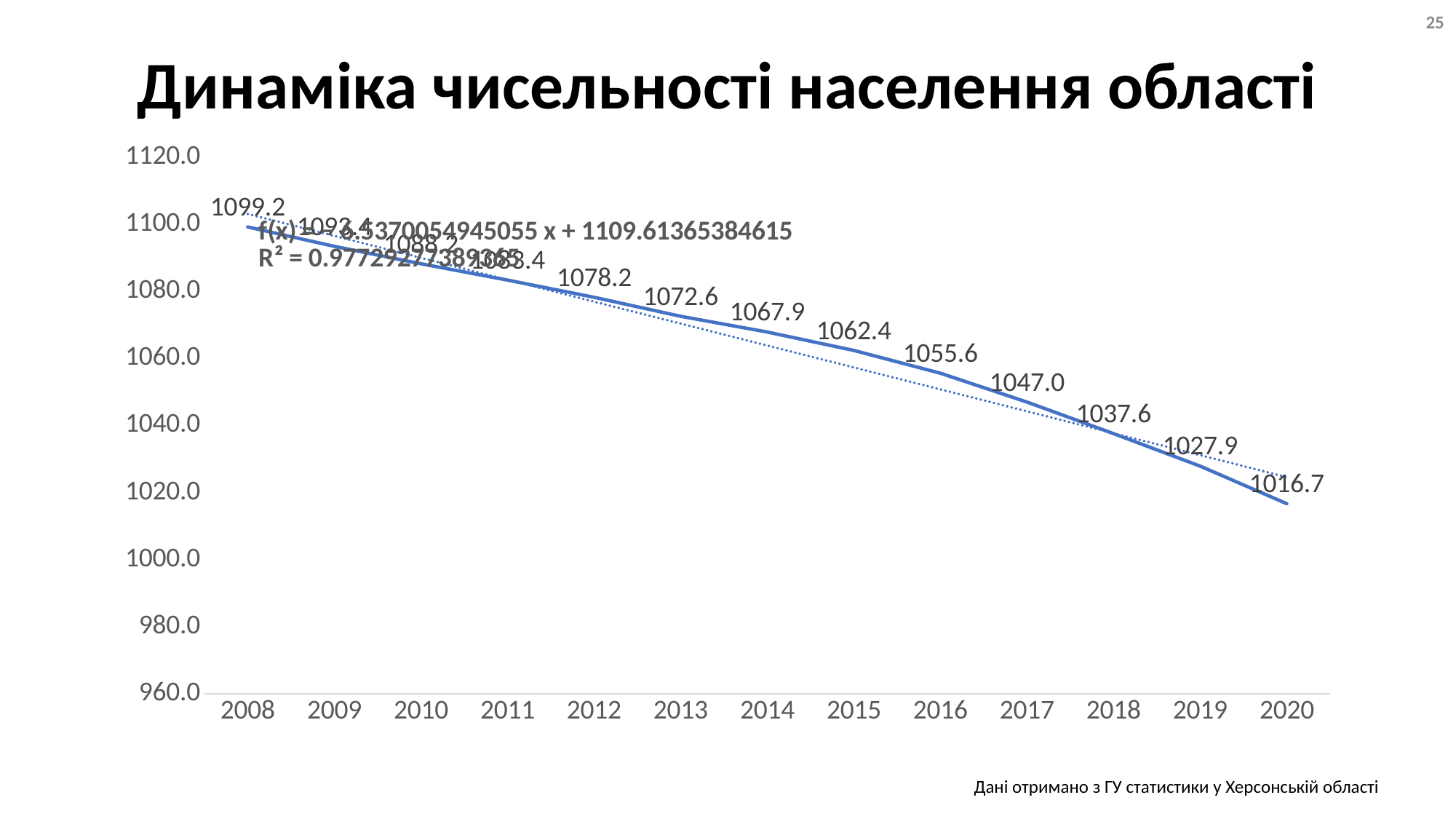
Do the values rise or fall from 2008 to 2020? fall Which is larger, the value for 2013 or the value for 2014? 2013 Which year has the highest value on the chart? 2008 What is the difference between the values for 2016 and 2017? 8.6 How many years are plotted on the x axis? 13 What is the value shown for 2018? 1037.6 Which year has the lowest value on the chart? 2020 What is the value shown for 2015? 1062.4 What is the population value shown for 2008? 1099.2 What is the difference between the values for 2008 and 2020? 82.5 What is the population value shown for 2020? 1016.7 What type of chart is shown on the slide? line chart